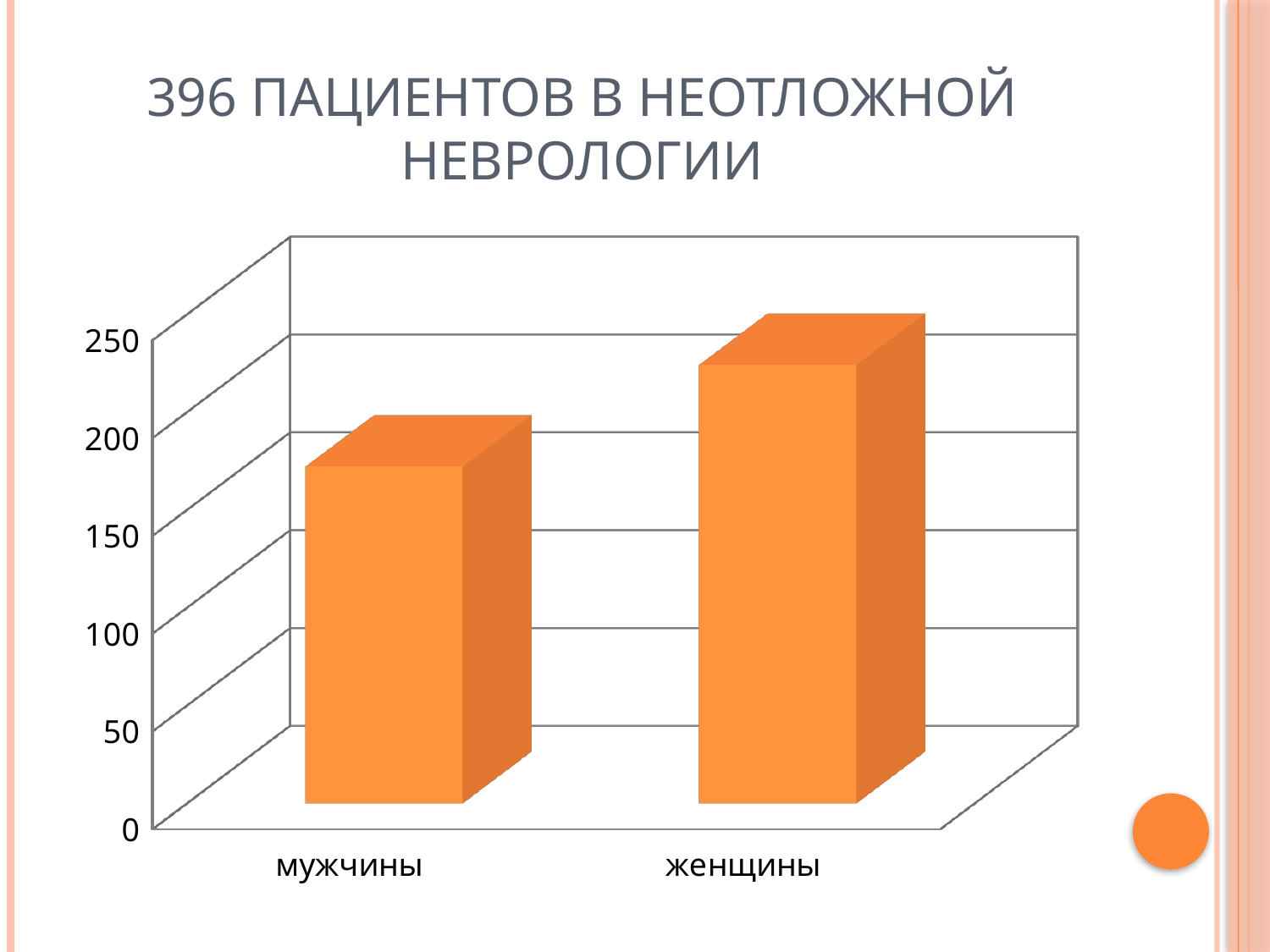
How many categories are shown on the x axis of the chart? 2 Is the value for женщины greater or less than 200? greater Is the value for женщины greater or less than 150? greater Do the values rise or fall from мужчины to женщины along the x axis? rise Is the value for мужчины greater or less than 150? greater What is the highest value labelled on the vertical axis of the chart? 250 What kind of chart is shown on the slide? bar chart What is the title of the slide containing the chart? 396 ПАЦИЕНТОВ В НЕОТЛОЖНОЙ НЕВРОЛОГИИ Which category has the lowest bar? мужчины Which is larger, the value for мужчины or the value for женщины? женщины Which category has the highest bar? женщины